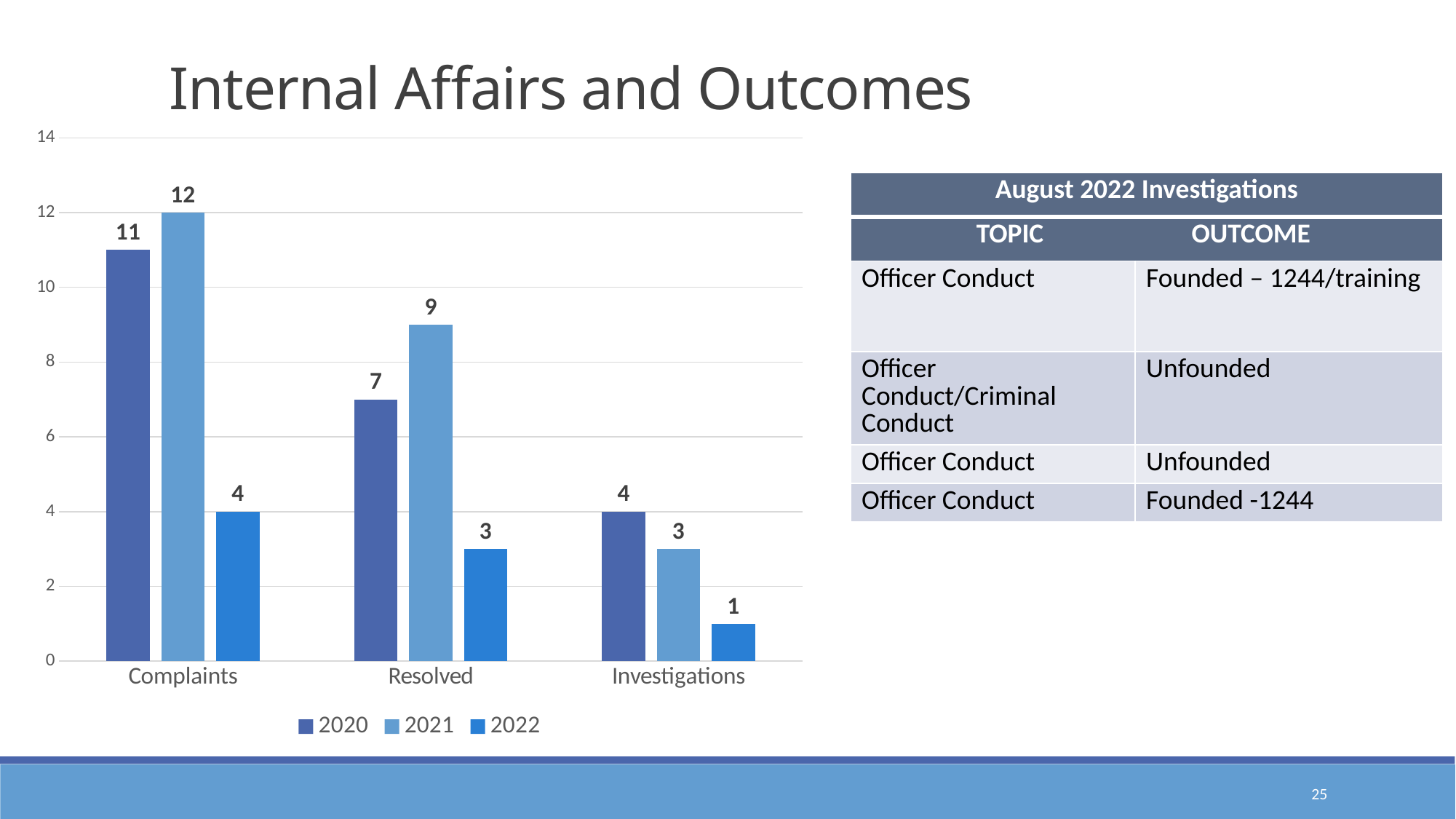
Which category has the highest value for the 2021 series? Complaints What is the value for Resolved in 2020? 7 How many categories are shown on the x axis of the chart? 3 What kind of chart is shown on the slide? bar chart What is the value for Investigations in 2022? 1 What years are listed in the chart legend? 2020, 2021, 2022 What is the difference between the 2021 and 2022 values for Complaints? 8 Which category has the lowest value for the 2022 series? Investigations What is the value for Complaints in 2021? 12 Which is larger: the 2020 value for Resolved or the 2021 value for Resolved? 2021 How many series does the chart legend list? 3 Do the 2022 values rise or fall from Complaints to Investigations? fall